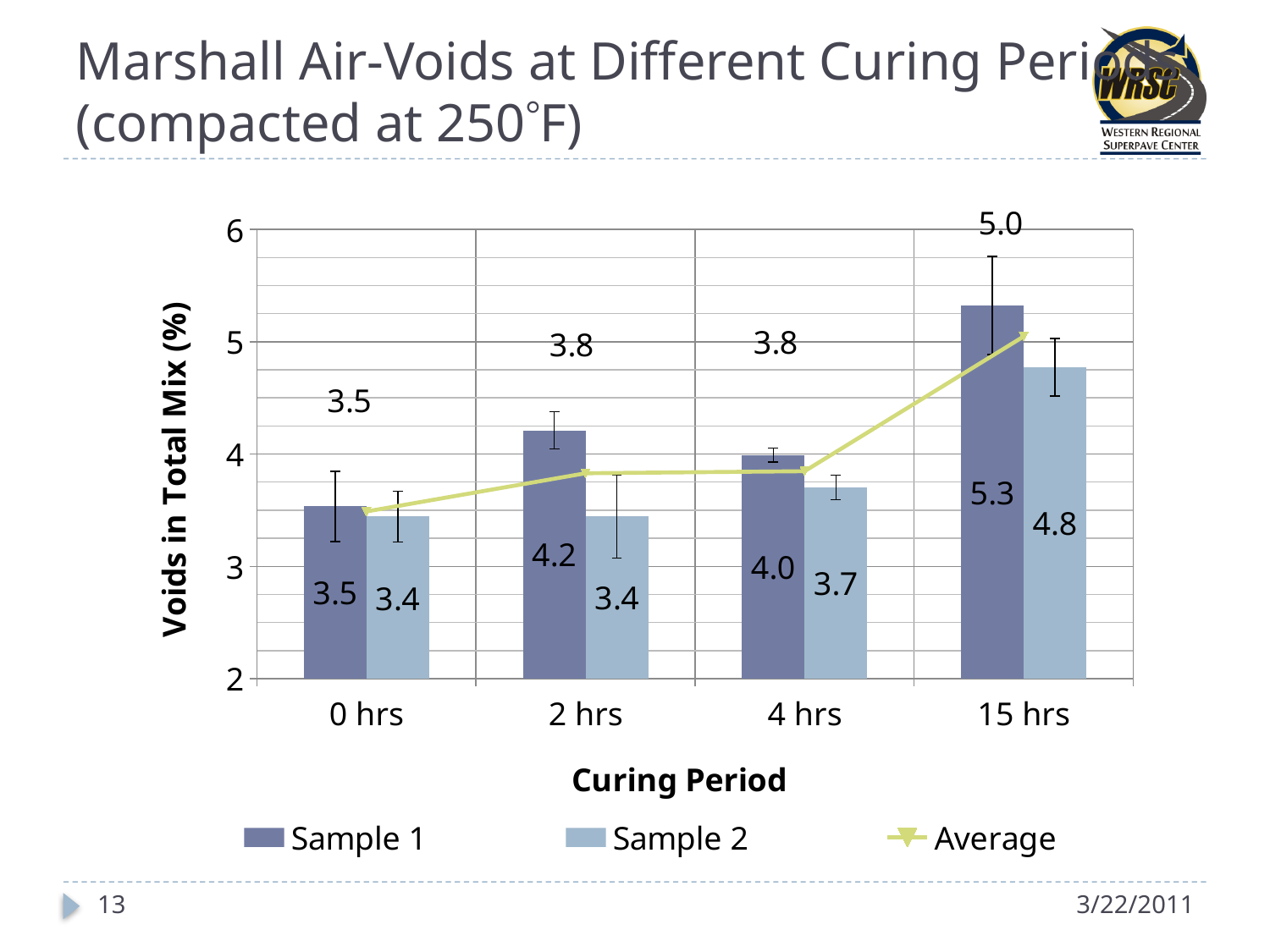
What is the label of the y axis? Voids in Total Mix (%) What is the Sample 1 value at 15 hrs? 5.3 How many curing periods are shown on the x axis? 4 What kind of chart is used for Sample 1 and Sample 2? Bar chart What is the Sample 2 value at 4 hrs? 3.7 Which curing period has the lowest Average value? 0 hrs Which is larger at 2 hrs, Sample 1 or Sample 2? Sample 1 Is the Sample 2 value at 15 hrs greater or less than 4? greater What is the difference between the Sample 1 and Sample 2 values at 15 hrs? 0.5 Which curing period has the highest Sample 1 value? 15 hrs How many series does the legend list? 3 What is the Average value at 2 hrs? 3.8